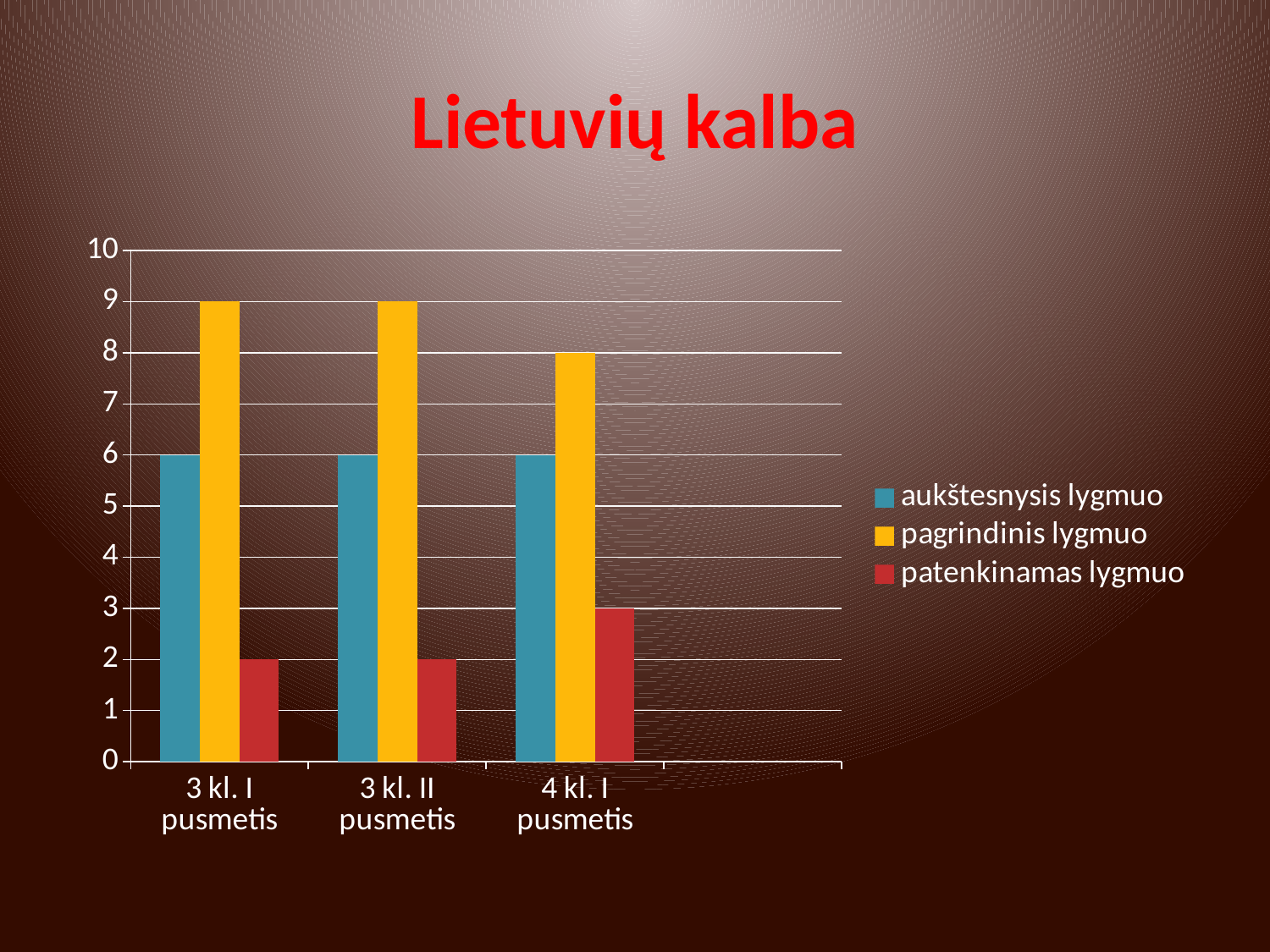
What is the value of patenkinamas lygmuo for 4 kl. I pusmetis? 3 What is the value of pagrindinis lygmuo for 3 kl. I pusmetis? 9 Does the value of pagrindinis lygmuo rise or fall from 3 kl. II pusmetis to 4 kl. I pusmetis? fall Which is larger: pagrindinis lygmuo for 3 kl. I pusmetis or pagrindinis lygmuo for 4 kl. I pusmetis? 3 kl. I pusmetis Which series has the lowest value for 3 kl. I pusmetis? patenkinamas lygmuo What is the value of aukštesnysis lygmuo for 3 kl. II pusmetis? 6 What is the difference between pagrindinis lygmuo and patenkinamas lygmuo for 3 kl. II pusmetis? 7 How many categories are shown on the x axis? 3 How many series does the legend list? 3 Which series has the highest value for 4 kl. I pusmetis? pagrindinis lygmuo What kind of chart is shown on the slide? bar chart What is the title of the chart on the slide? Lietuvių kalba